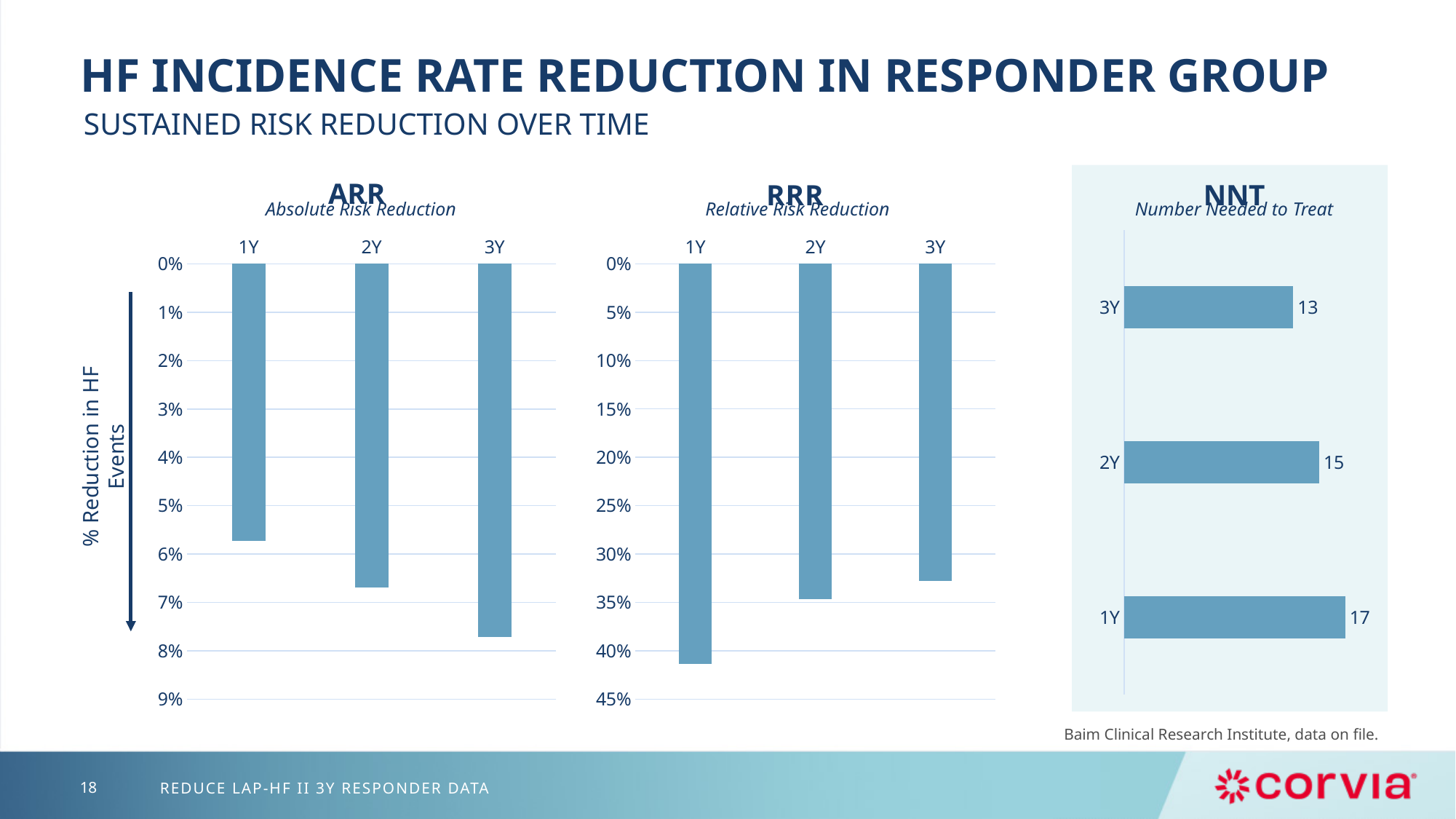
In the NNT chart, what is the Number Needed to Treat at 1Y? 17 In the NNT chart, which time point has the highest value? 1Y In the ARR chart, is the value for 3Y greater or less than 7%? greater In the NNT chart, what is the value for 3Y? 13 In the ARR chart, is the value for 1Y greater or less than 6%? less In the RRR chart, is the value for 3Y greater or less than 35%? less In the RRR chart, which time point shows the largest relative risk reduction? 1Y How many time points are plotted in the NNT chart? 3 In the ARR chart, which time point shows the largest absolute risk reduction? 3Y In the NNT chart, what is the difference between the 1Y and 3Y values? 4 In the NNT chart, which time point has the lowest Number Needed to Treat? 3Y